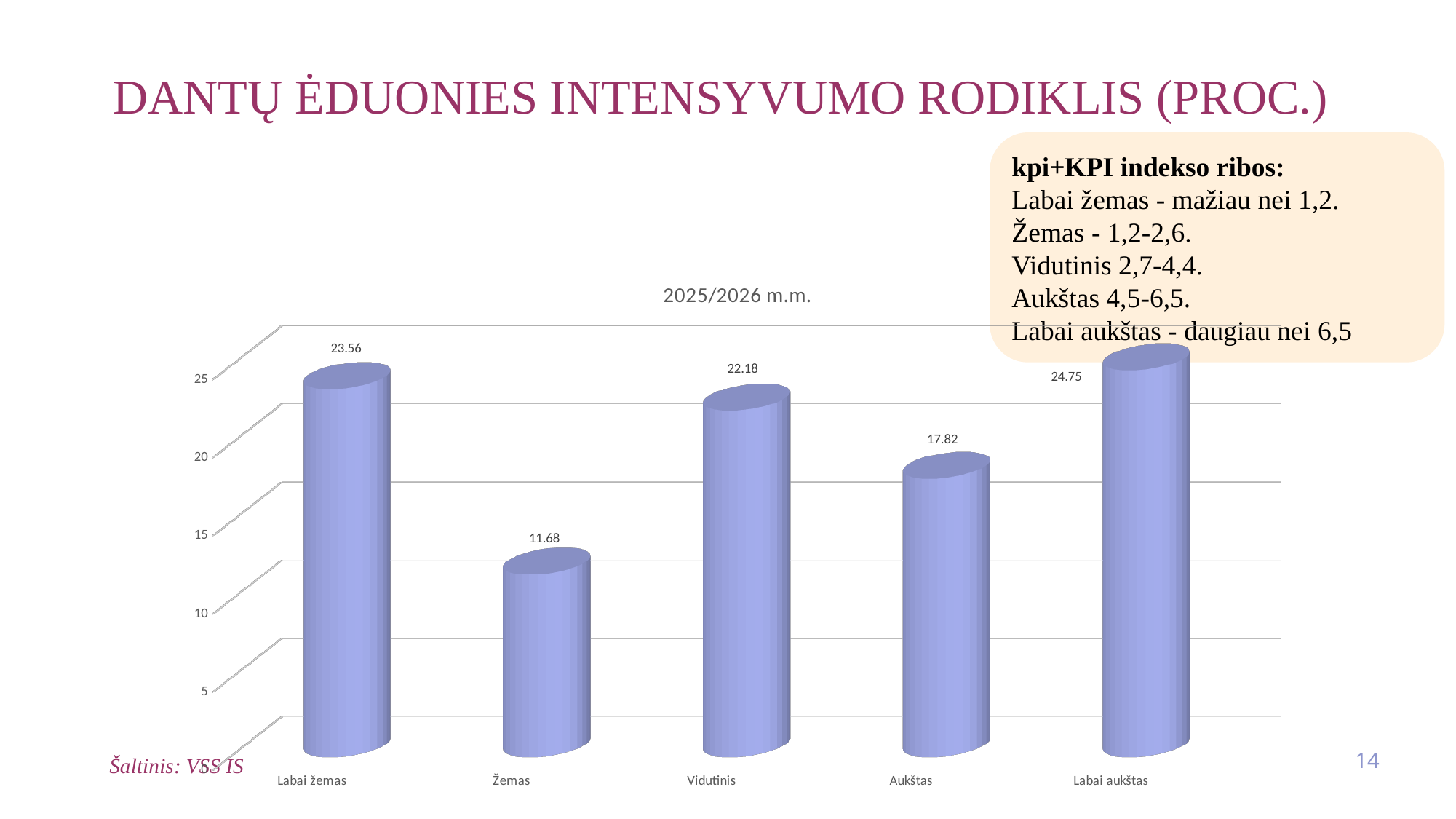
What is the value for Aukštas? 17.82 How many categories are shown on the x axis? 5 Which category has the lowest value? Žemas What is the value for Vidutinis? 22.18 Which is larger, the value for Vidutinis or the value for Aukštas? Vidutinis What is the value for Labai aukštas? 24.75 What is the difference between the values for Labai aukštas and Žemas? 13.07 What is the difference between the values for Vidutinis and Aukštas? 4.36 What is the title shown above the chart? 2025/2026 m.m. What is the value for Labai žemas? 23.56 Which category has the highest value? Labai aukštas What is the value for Žemas? 11.68